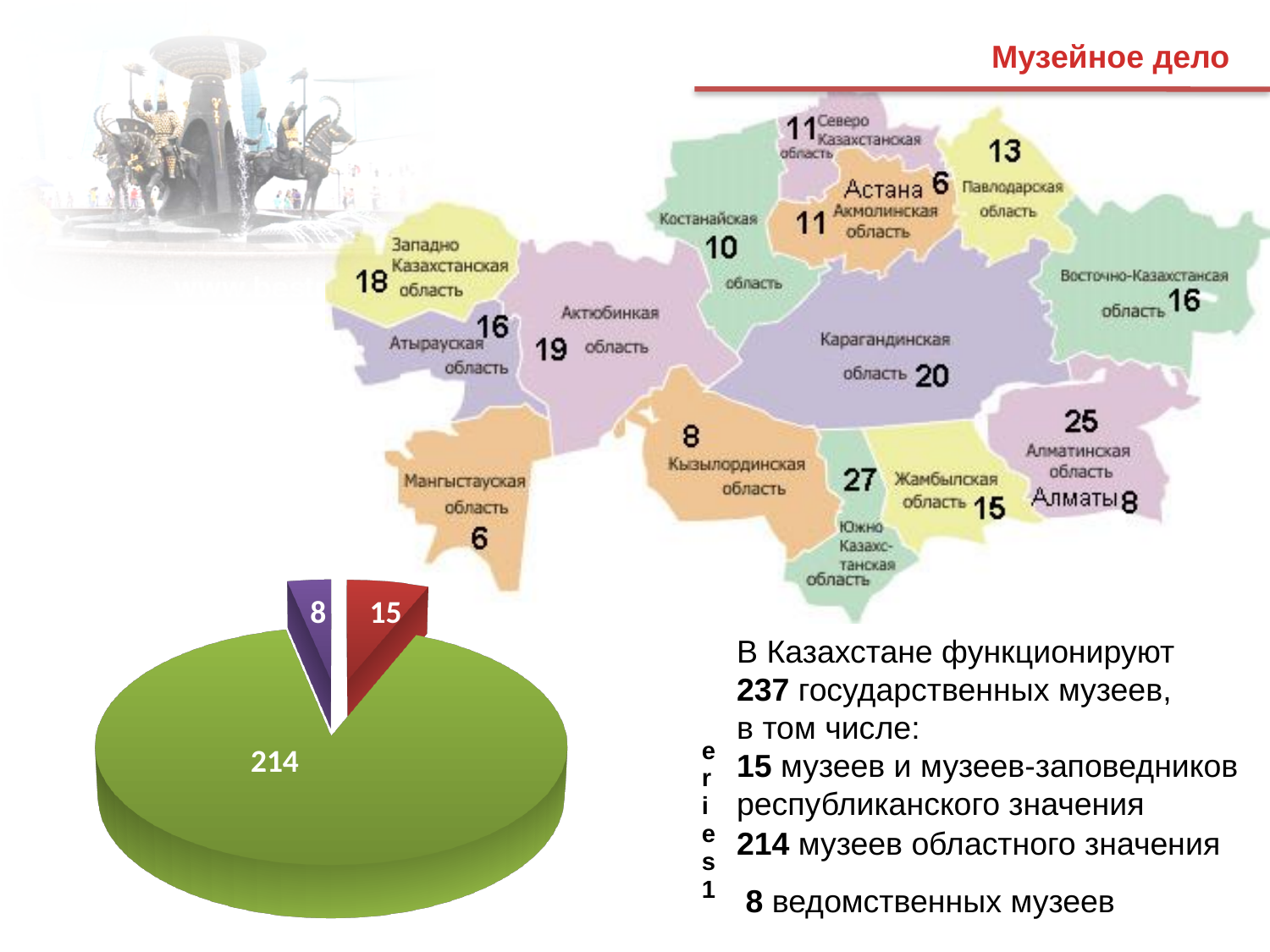
What value is shown on the green slice of the pie chart? 214 What is the value of the largest slice of the pie chart? 214 Which slice of the pie chart is larger, the red one or the purple one? the red one (15) What value is shown on the red slice of the pie chart? 15 What is the total of all slices in the pie chart? 237 What kind of chart is shown at the bottom left of the slide? pie chart What is the difference between the red slice (15) and the purple slice (8) in the pie chart? 7 What is the value of the smallest slice of the pie chart? 8 What is the difference between the green slice (214) and the red slice (15) in the pie chart? 199 What value is shown on the purple slice of the pie chart? 8 How many slices does the pie chart have? 3 How many series does the legend of the pie chart list? 1